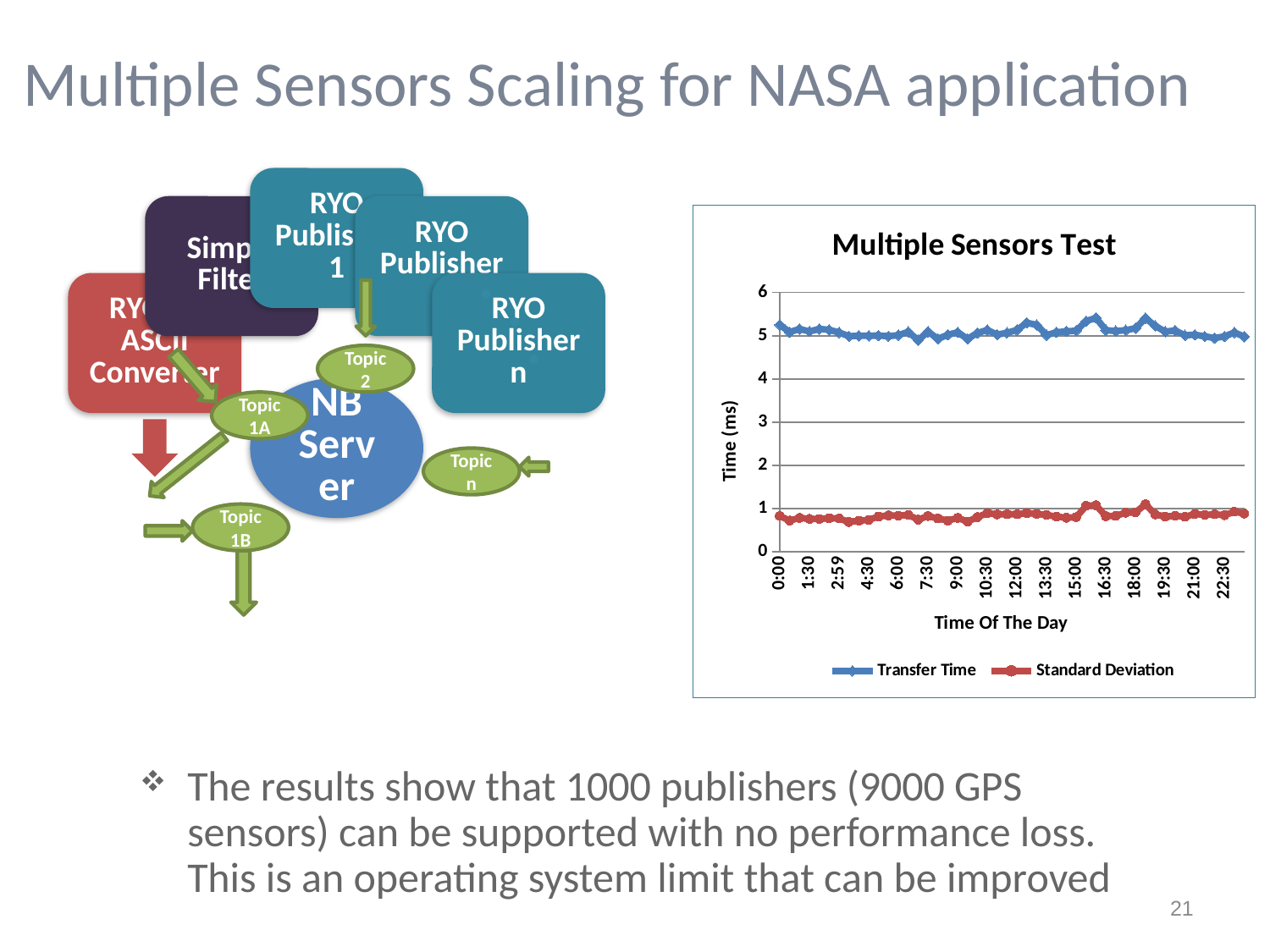
How many series does the legend of the "Multiple Sensors Test" chart list? 2 Is the Transfer Time value at 22:30 greater or less than 3? greater Is the Standard Deviation value at 6:00 greater or less than 3? less Is the Transfer Time value at 0:00 greater or less than 4? greater At 9:00, which series has the larger value, Transfer Time or Standard Deviation? Transfer Time What kind of chart is the "Multiple Sensors Test" chart? line chart Which series has the lower values across the day, Transfer Time or Standard Deviation? Standard Deviation How many time labels are shown on the x axis of the "Multiple Sensors Test" chart? 16 What is the label of the y axis on the "Multiple Sensors Test" chart? Time (ms) What is the title of the chart on the slide? Multiple Sensors Test